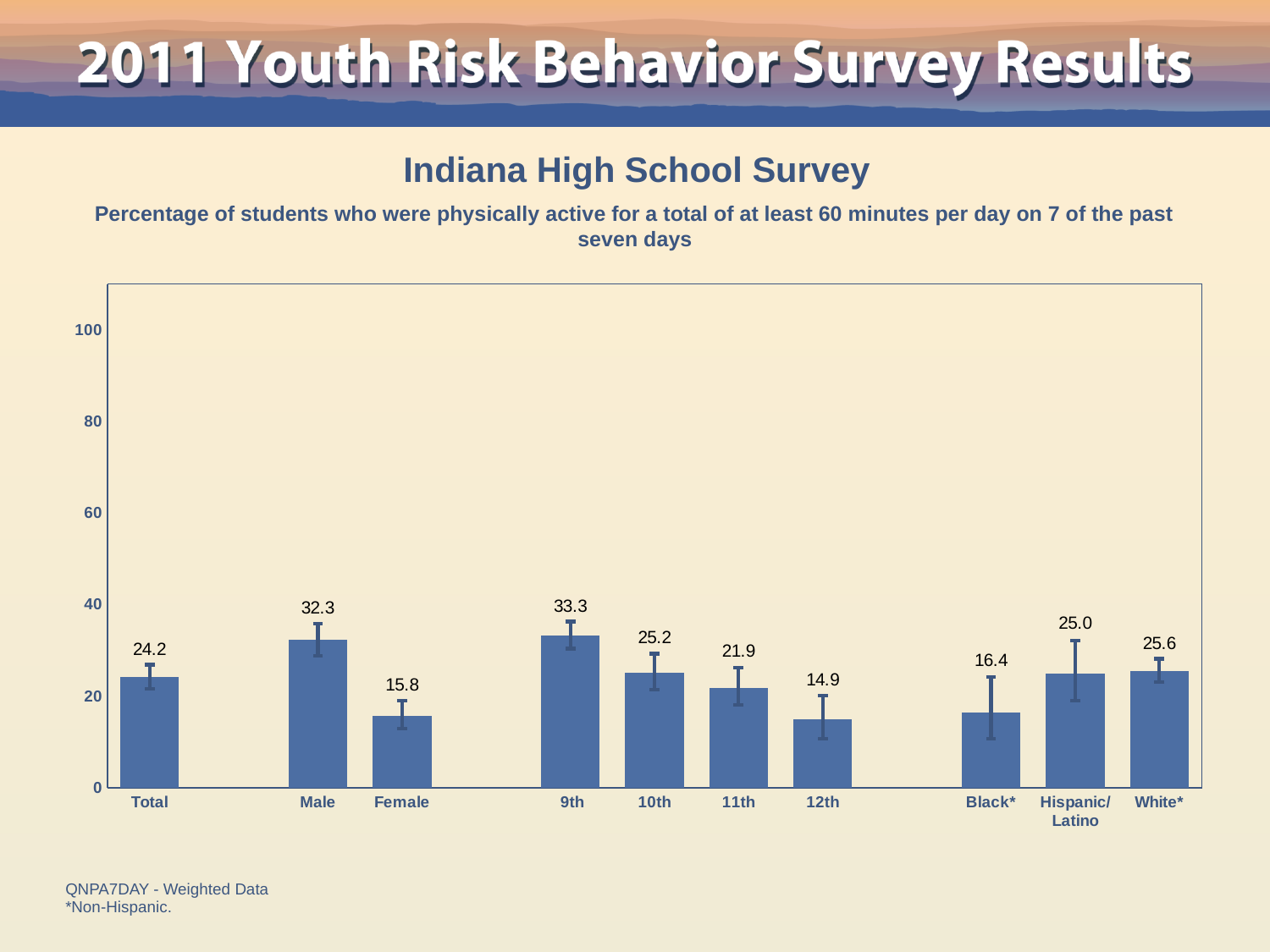
How many categories are shown on the x axis? 10 What is the difference between the values for Male and Female? 16.5 Which is larger, the value for White* or the value for Black*? White* What kind of chart is shown? bar chart Which category has the lowest value? 12th What is the difference between the values for 9th and 12th? 18.4 What is the value for Total? 24.2 What is the value for Female? 15.8 Do the values rise or fall from 9th to 12th grade? fall Which category has the highest value? 9th What is the value for Hispanic/Latino? 25.0 Is the value for 11th greater or less than 40? less